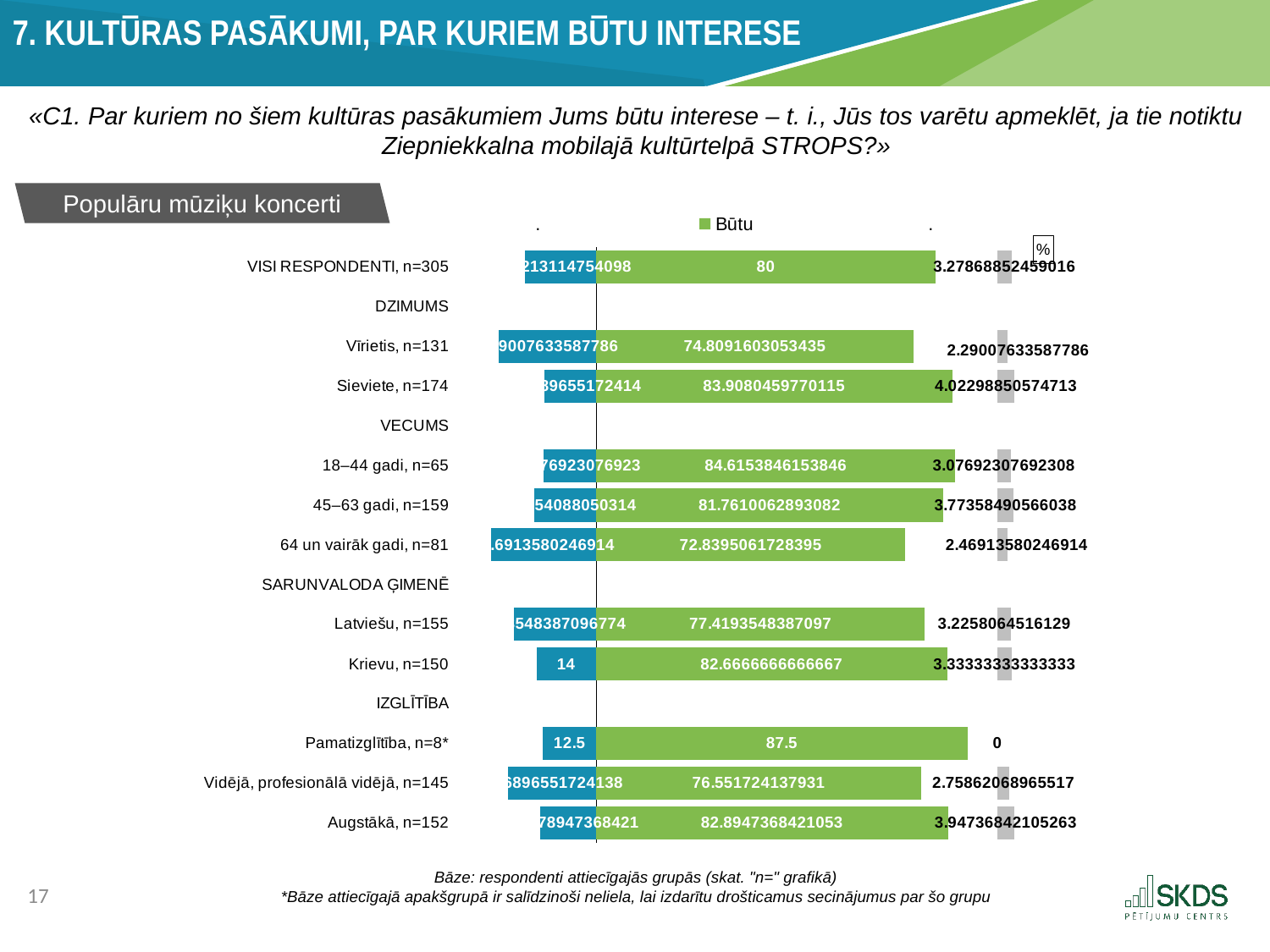
Which group has the highest 'Būtu' value? Pamatizglītība, n=8* What type of chart is shown on the slide? bar chart Which has a larger 'Būtu' value, Vīrietis, n=131 or Sieviete, n=174? Sieviete, n=174 What is the difference between the green 'Būtu' value and the blue value for Pamatizglītība, n=8*? 75 How many groups have bars plotted in the chart? 11 Which series name is shown in the chart legend? Būtu Which group has the lowest 'Būtu' value? 64 un vairāk gadi, n=81 What is the value of the grey segment for Vīrietis, n=131? 2.29007633587786 What is the 'Būtu' value for Sieviete, n=174? 83.9080459770115 What is the 'Būtu' value for VISI RESPONDENTI, n=305? 80 What is the 'Būtu' value for Krievu, n=150? 82.6666666666667 What is the value of the blue segment for Pamatizglītība, n=8*? 12.5